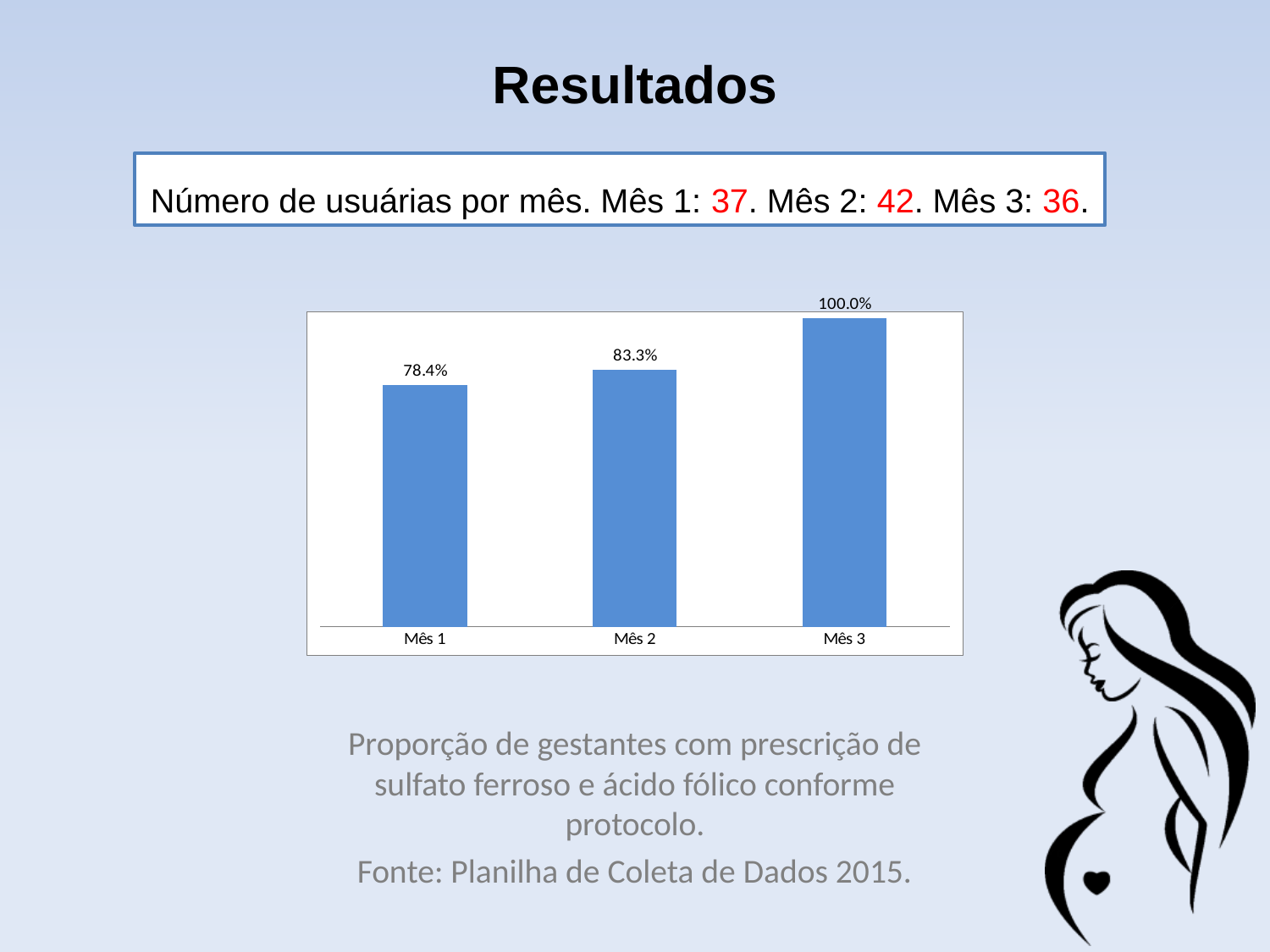
Do the values rise or fall from Mês 1 to Mês 3? Rise What is the difference between the values for Mês 3 and Mês 1? 21.6% What is the difference between the values for Mês 2 and Mês 1? 4.9% What is the value for Mês 1? 78.4% Which is larger, the value for Mês 2 or the value for Mês 1? Mês 2 Which month has the highest value? Mês 3 What colour are the bars in the chart? Blue How many categories are shown on the x axis of the chart? 3 Which month has the lowest value? Mês 1 What is the value for Mês 3? 100.0% What is the value for Mês 2? 83.3% What kind of chart is shown on the slide? Bar chart